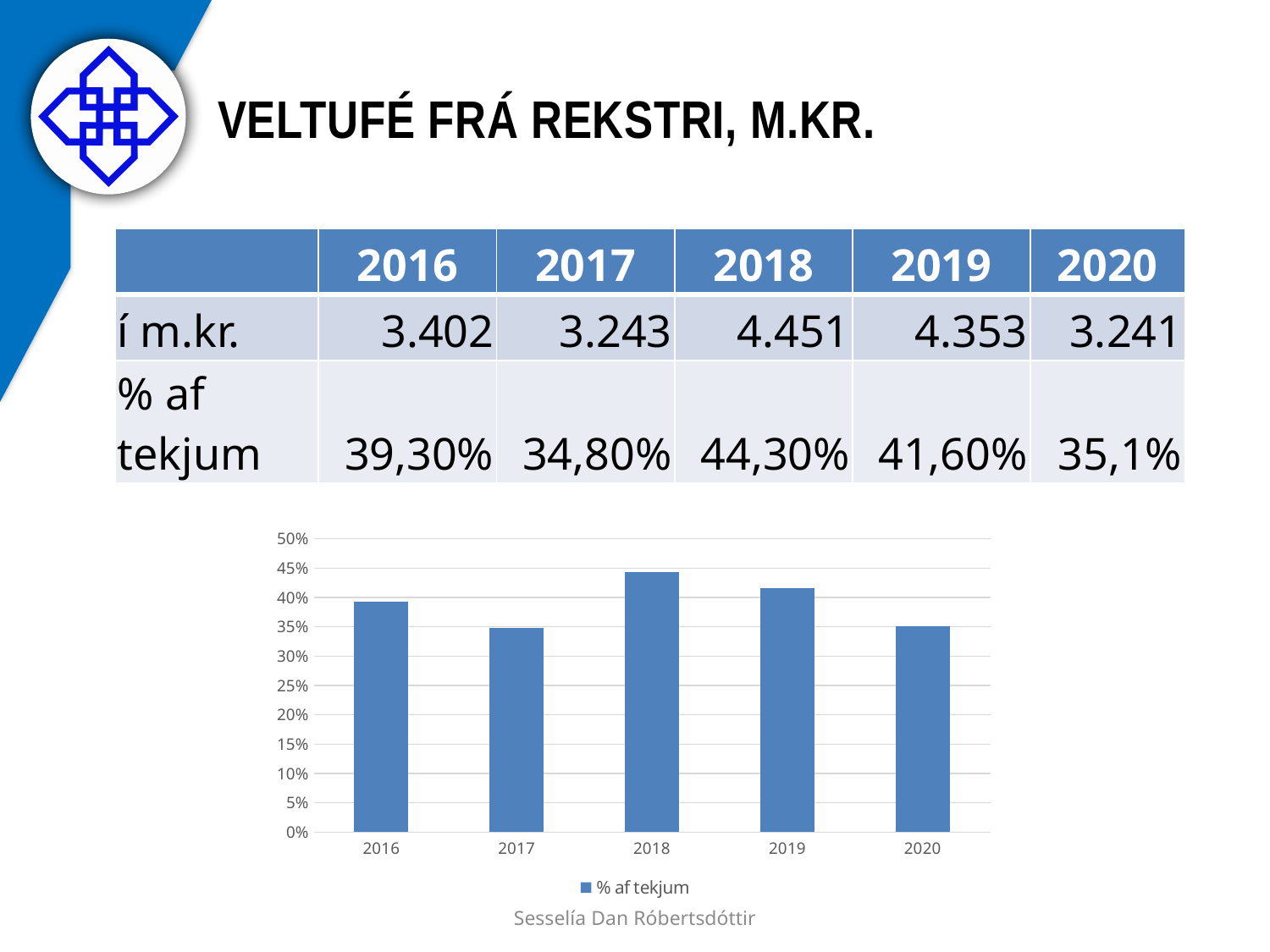
How many series does the chart legend list? 1 According to the table, what is the % af tekjum value for 2018? 44,30% Which bar is taller in the chart, 2016 or 2019? 2019 What kind of chart is shown on the slide? bar chart Does the bar height rise or fall from 2019 to 2020 in the chart? fall Which year has the highest bar in the chart? 2018 Which year has the lowest bar in the chart? 2017 What is the name of the series shown in the chart legend? % af tekjum How many years are plotted on the x axis of the chart? 5 Is the value for 2018 in the chart greater or less than 40%? greater Is the value for 2020 in the chart greater or less than 40%? less